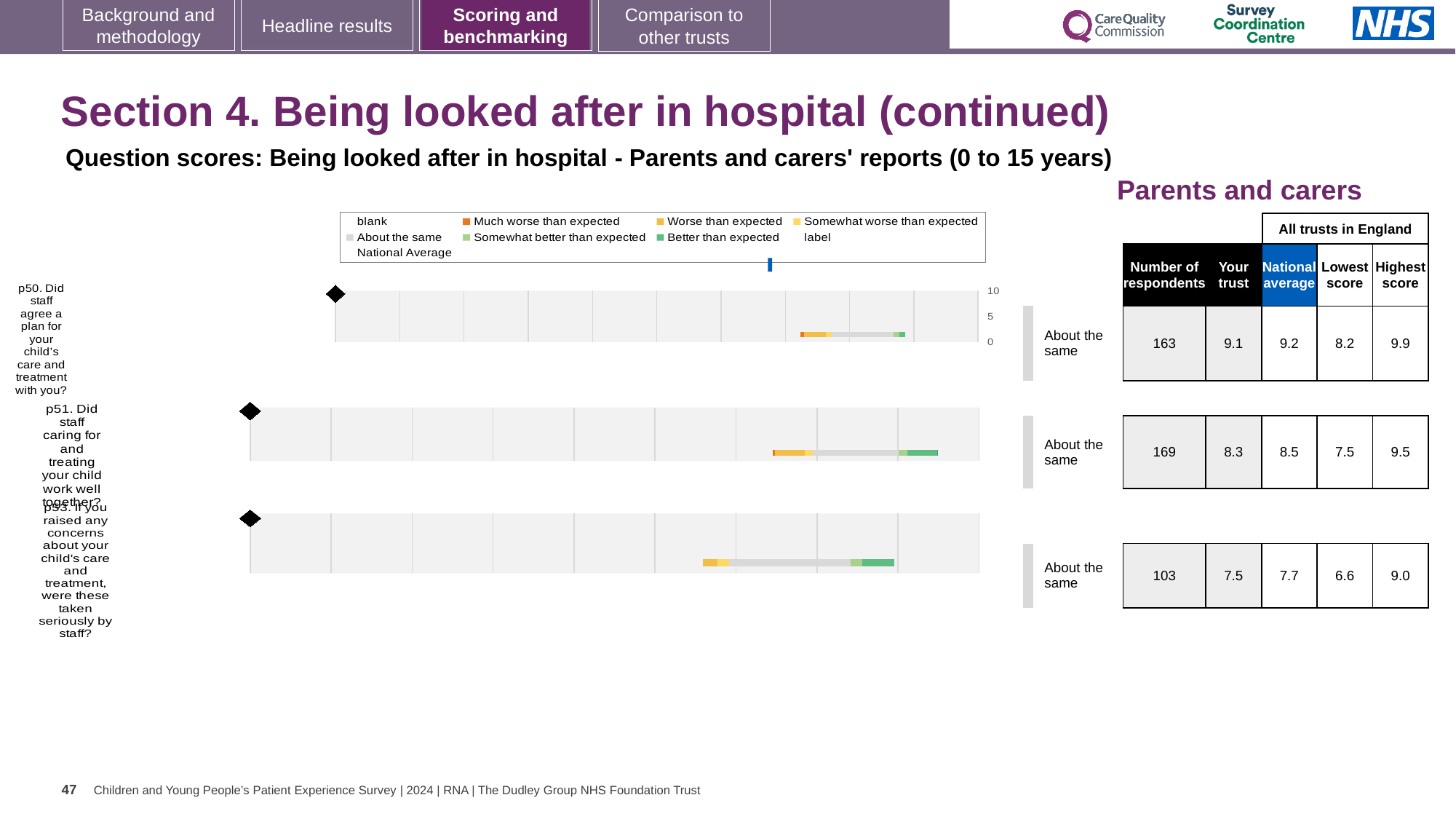
What is the 'Your trust' score for p50 (Did staff agree a plan for your child's care and treatment with you?)? 9.1 What kind of chart is used to show the question scores on this slide? bar chart What is the difference between the national average and the 'Your trust' score for p51? 0.2 What is the lowest score among all trusts in England for p53 (If you raised any concerns about your child's care and treatment, were these taken seriously by staff?)? 6.6 For p50, which is larger: the 'Your trust' score or the national average? National average Which question has the lowest 'Your trust' score? p53 How many questions (categories) are plotted in the question scores chart? 3 How many respondents answered p51? 169 Which question has the highest 'Your trust' score? p50 Is the 'Your trust' score for p53 greater or less than 5 on the chart axis? greater What benchmark category is shown for all three questions on this slide? About the same What is the national average score for p51 (Did staff caring for and treating your child work well together?)? 8.5